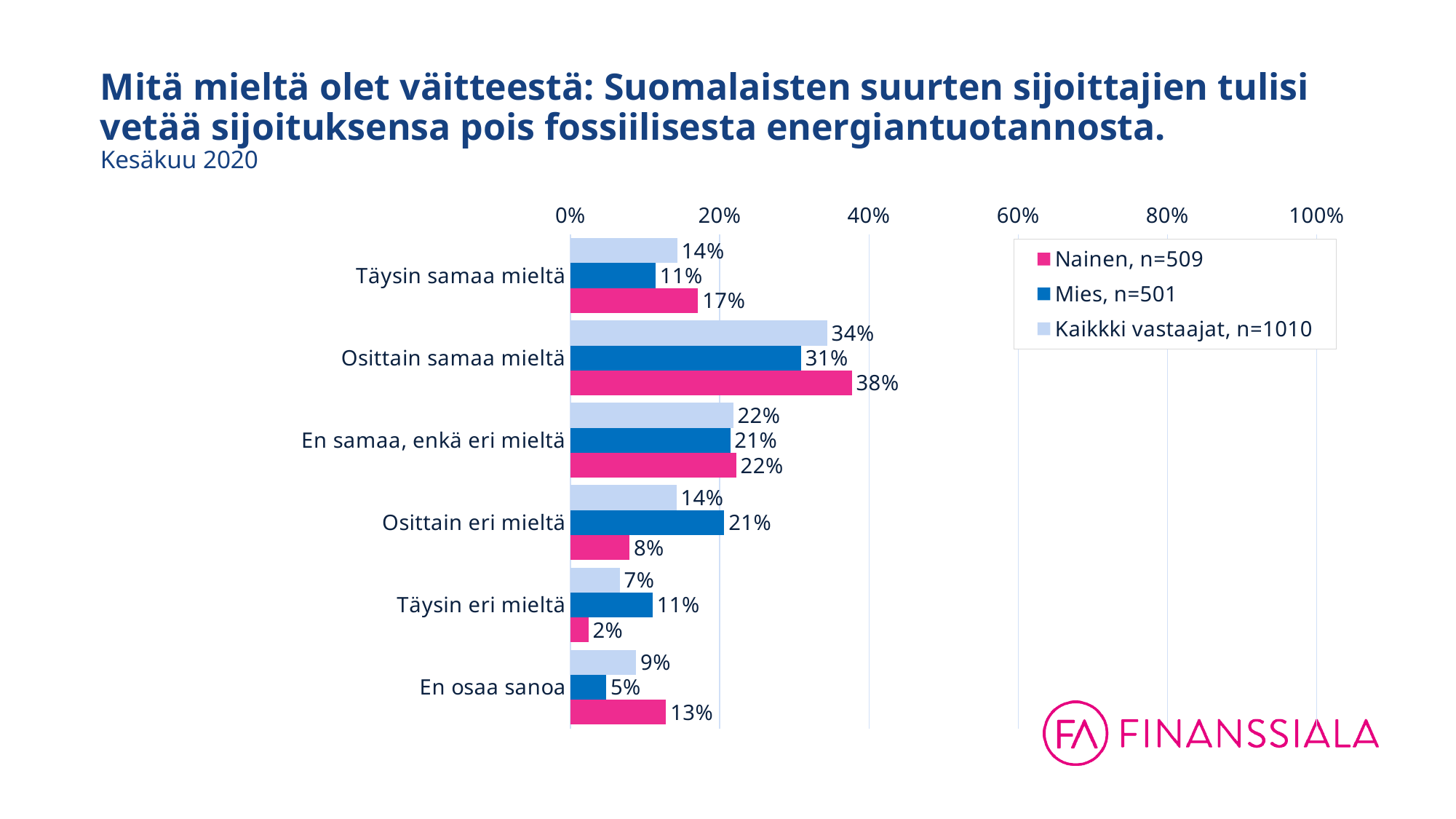
How many categories are shown on the chart? 6 In the "Täysin eri mieltä" category, which is larger: the value for "Mies, n=501" or for "Nainen, n=509"? Mies, n=501 What kind of chart is shown on the slide? bar chart Which category has the lowest value for the "Nainen, n=509" series? Täysin eri mieltä Which category has the highest value for the "Kaikkki vastaajat, n=1010" series? Osittain samaa mieltä How many series does the legend list? 3 What is the value for "Mies, n=501" in the "Osittain eri mieltä" category? 21% What colour are the bars for the "Nainen, n=509" series? pink What is the value for "Kaikkki vastaajat, n=1010" in the "En osaa sanoa" category? 9% What is the difference between the "Nainen, n=509" and "Mies, n=501" values in the "Osittain eri mieltä" category? 13% What is the value for "Nainen, n=509" in the "Osittain samaa mieltä" category? 38% Is the value for "Nainen, n=509" in the "Osittain samaa mieltä" category greater or less than 20%? greater